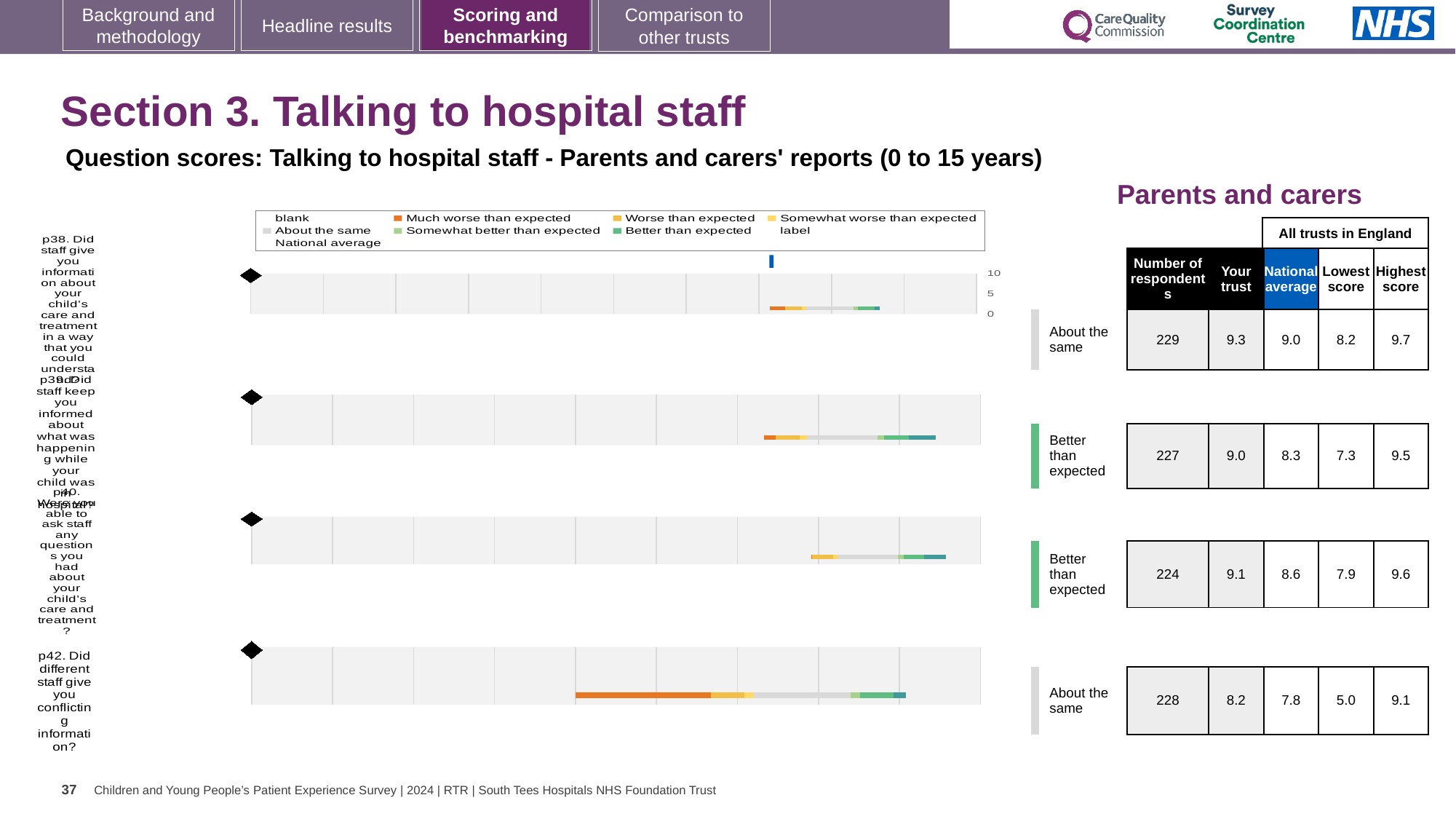
How many respondents answered p40 (were you able to ask staff any questions)? 224 How many questions (p38, p39, p40, p42) are plotted on the slide? 4 What is the lowest score across all trusts in England for p42? 5.0 What is the difference between the 'Your trust' score and the national average for p38? 0.3 Which question has the highest 'Your trust' score? p38 How many entries does the chart legend list? 9 What is the 'Your trust' score for p38 (staff giving information about your child's care in a way you could understand)? 9.3 What is the national average score for p42 (different staff giving conflicting information)? 7.8 For p39, is the 'Your trust' score or the national average score larger? Your trust What kind of chart is used to show the question scores on this slide? bar chart Which question has the lowest 'Your trust' score? p42 What is the highest score across all trusts in England for p38? 9.7